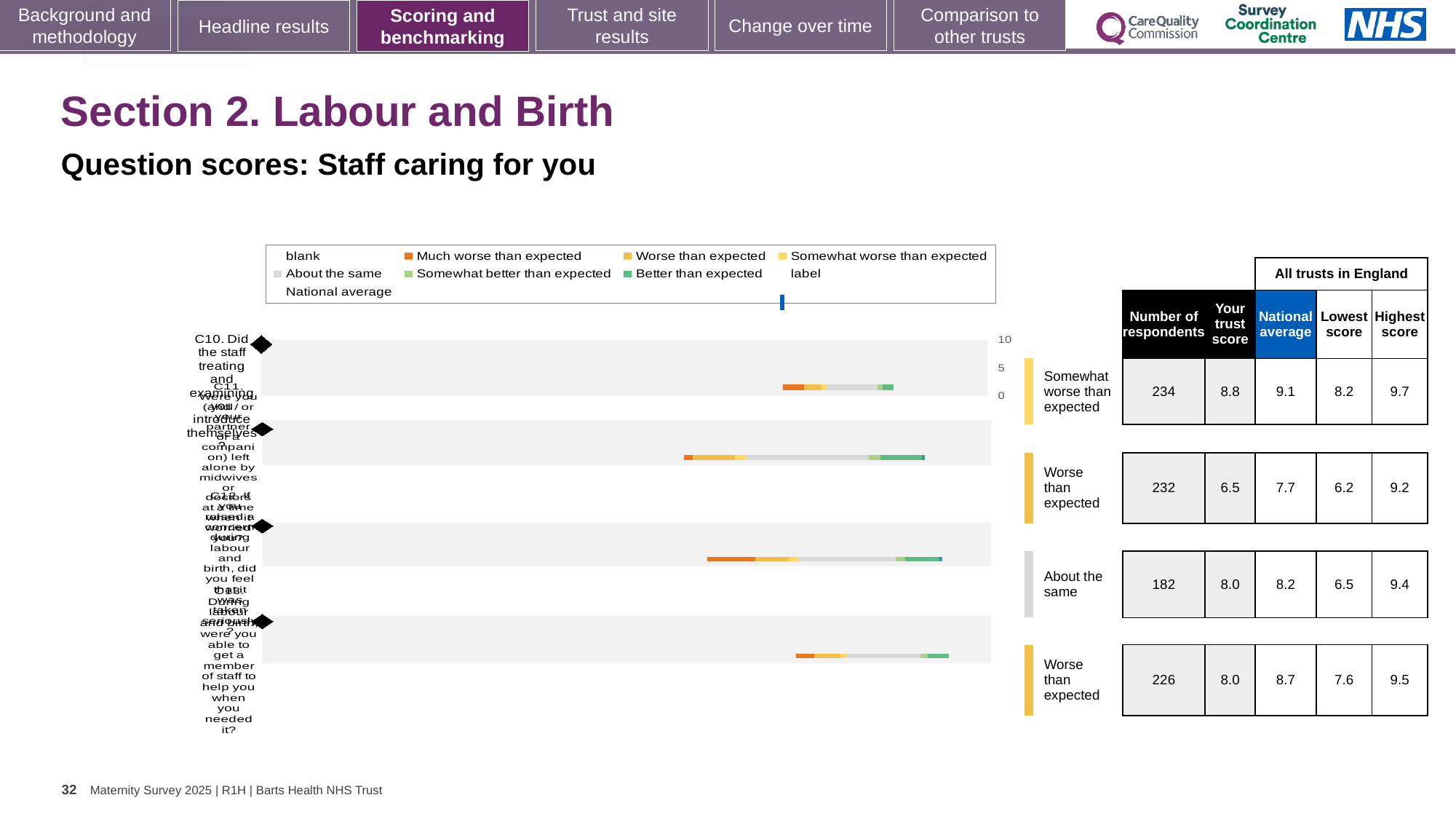
What is the trust score for the second row (Worse than expected)? 6.5 What is the title of the slide's chart section? Question scores: Staff caring for you What is the number of respondents for the first row (Somewhat worse than expected)? 234 Which row has the lowest number of respondents? the third row (About the same), 182 What is the difference between the national average and the trust score for the second row (Worse than expected, 232 respondents)? 1.2 What is the difference between the highest score and the lowest score for the second row (Worse than expected, 232 respondents)? 3.0 How many questions (rows) are plotted in the chart? 4 Which row has the highest number of respondents? the first row (Somewhat worse than expected), 234 What kind of chart is shown on the slide? bar chart What is the national average for the third row (About the same)? 8.2 For the first row (Somewhat worse than expected), which is larger: the trust score or the national average? the national average What is the highest score for the fourth row (Worse than expected, 226 respondents)? 9.5